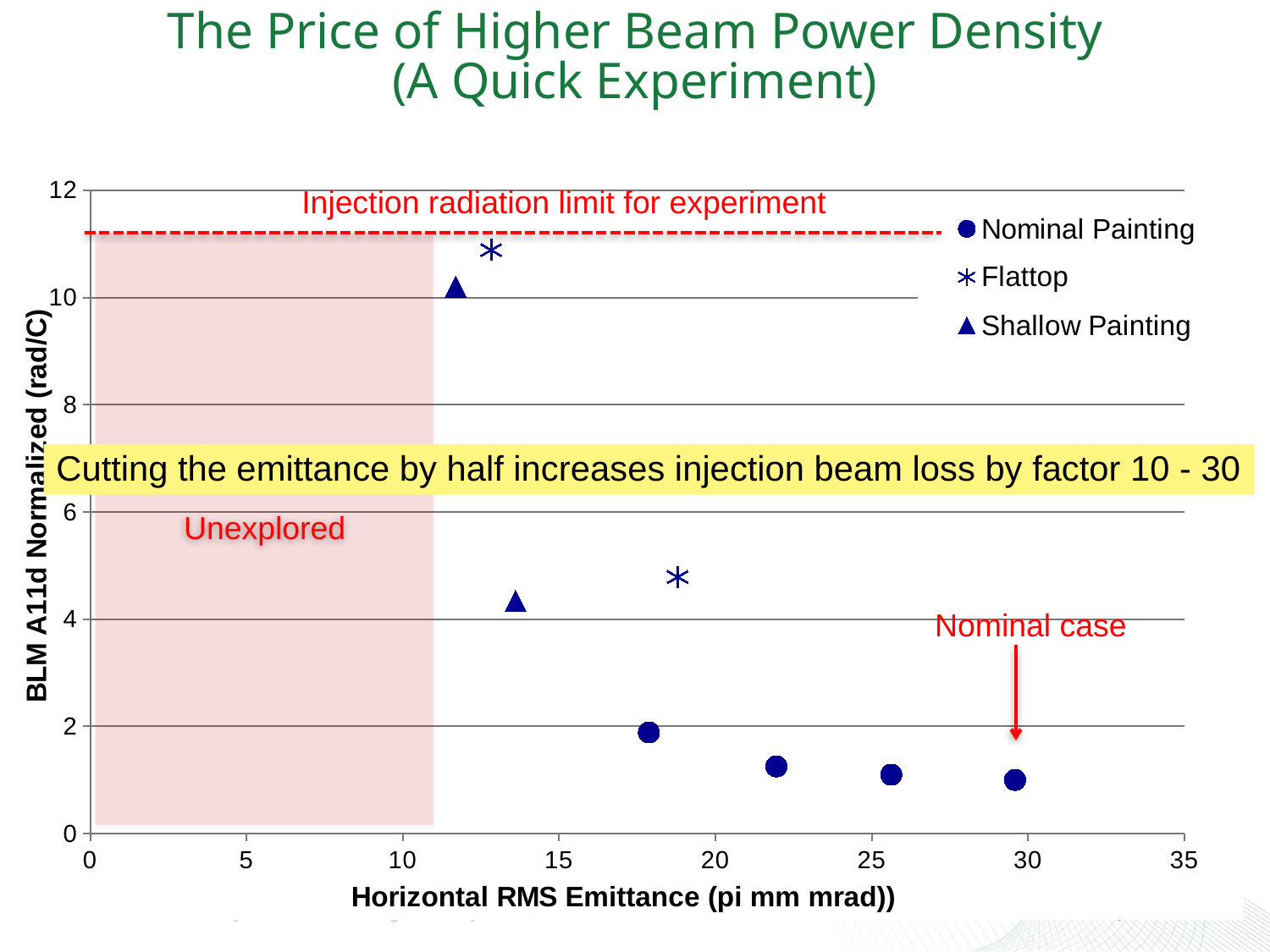
Which is larger: the Nominal Painting value at an emittance of about 18 or at about 30? about 18 Do the Nominal Painting values rise or fall as the horizontal emittance increases? fall How many Nominal Painting points are plotted? 4 Is the value of the highest Flattop point greater or less than 10? greater Is the value of the Flattop point at an emittance of about 19 greater or less than 6? less What are the three series named in the legend? Nominal Painting, Flattop, Shallow Painting What kind of chart is shown on the slide? scatter chart How many Shallow Painting points are plotted? 2 How many series does the legend list? 3 What is the title of the x axis? Horizontal RMS Emittance (pi mm mrad)) How many Flattop points are plotted? 2 Is the value of the Nominal Painting point at an emittance of about 30 greater or less than 2? less